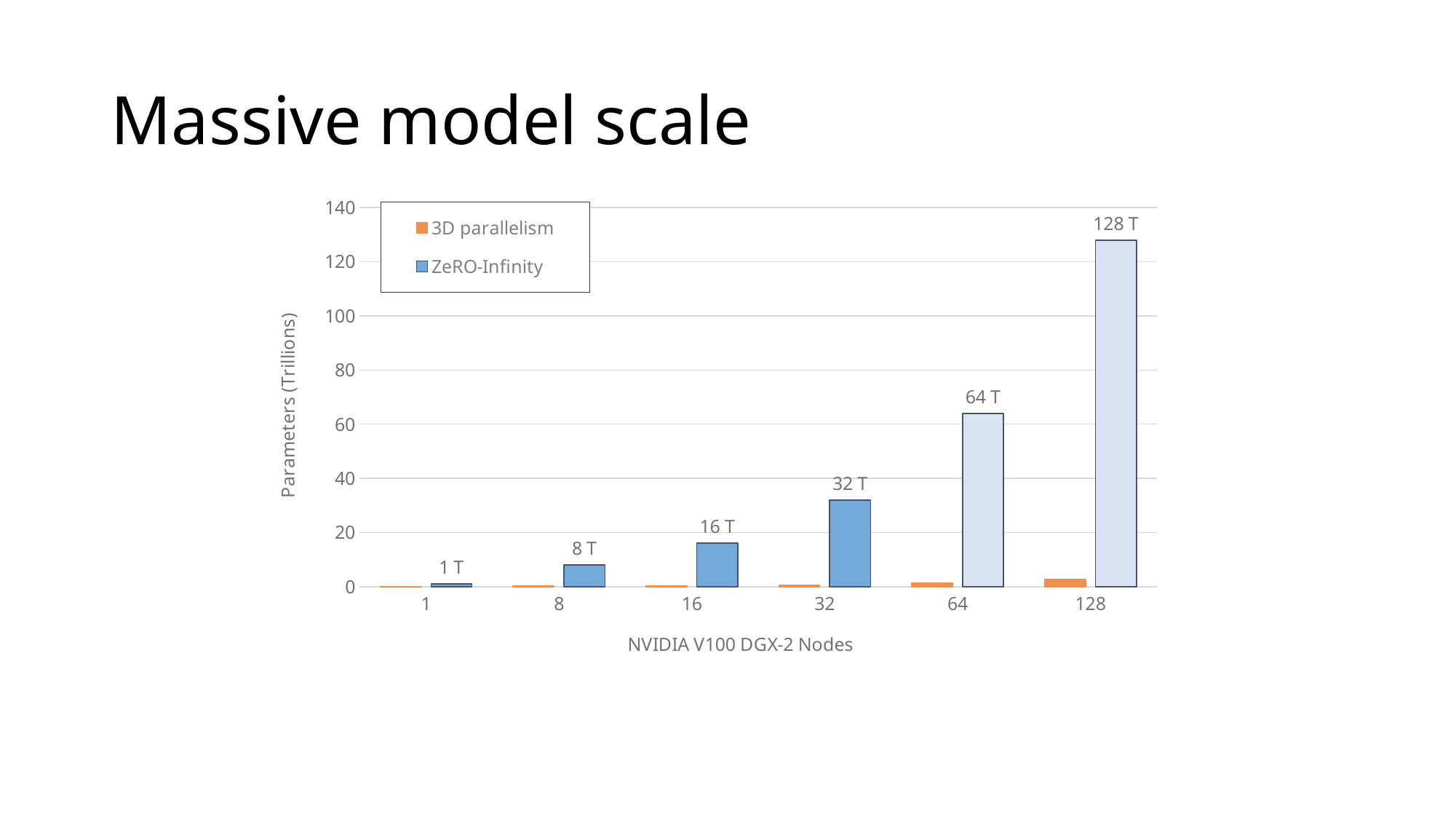
What is the ZeRO-Infinity value at 16 nodes? 16 T How many node counts are shown on the x axis? 6 At which number of nodes is the ZeRO-Infinity value lowest? 1 What is the ZeRO-Infinity value at 128 NVIDIA V100 DGX-2 Nodes? 128 T Which is larger at 32 nodes: the 3D parallelism bar or the ZeRO-Infinity bar? ZeRO-Infinity What is the difference between the ZeRO-Infinity values at 128 nodes and 64 nodes? 64 T How many series does the legend list? 2 What kind of chart is shown on the slide? bar chart At which number of nodes is the ZeRO-Infinity value highest? 128 Is the 3D parallelism value at 128 nodes greater or less than 20? less What is the ZeRO-Infinity value at 1 node? 1 T Do the ZeRO-Infinity values rise or fall as the number of nodes increases? rise